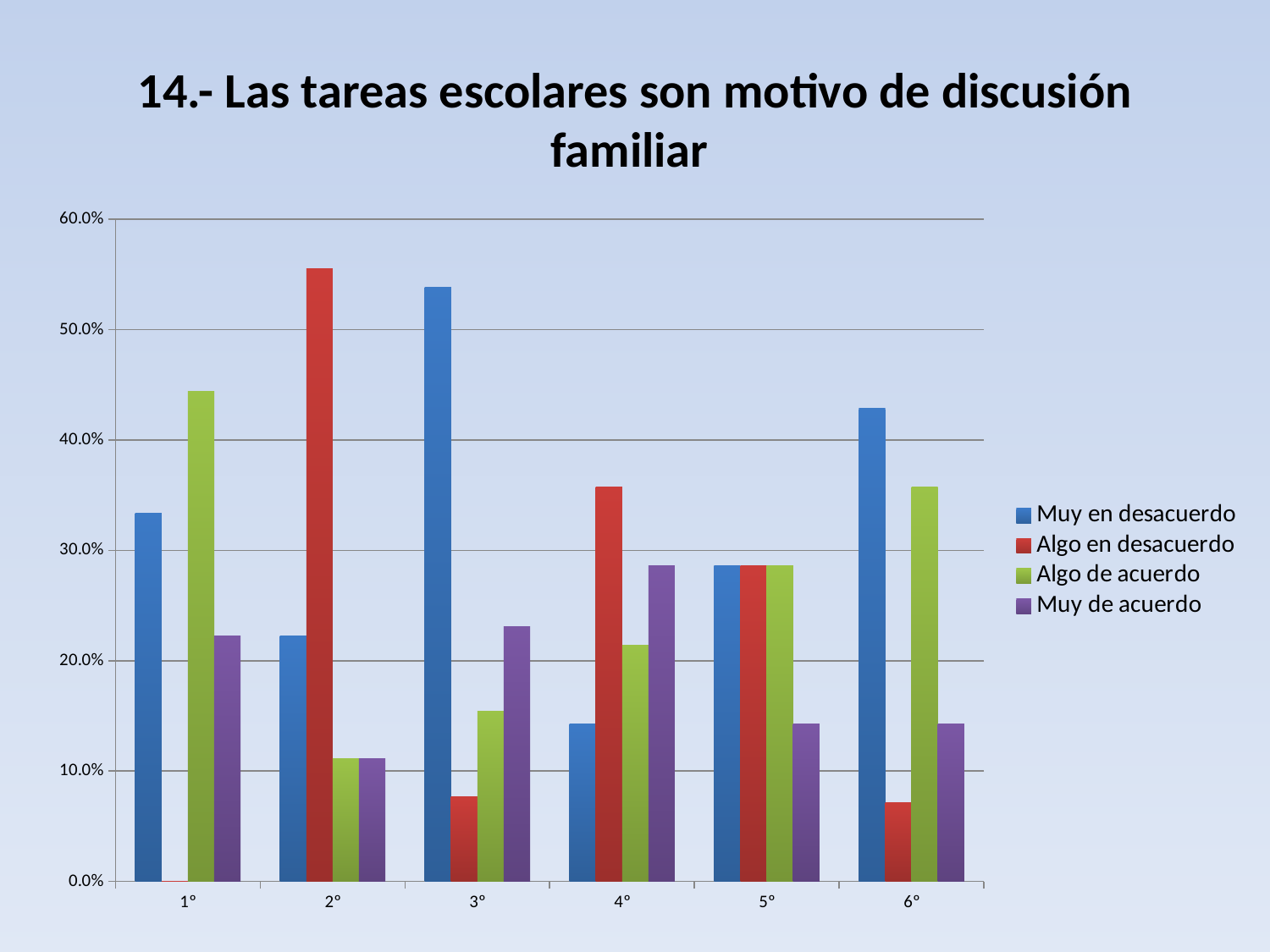
Is the value for 'Algo en desacuerdo' at 2° greater or less than 50.0%? greater Is the value for 'Algo en desacuerdo' at 3° greater or less than 10.0%? less What colour represents the 'Muy de acuerdo' series in the legend? Purple At 4°, which is larger: 'Algo en desacuerdo' or 'Muy en desacuerdo'? Algo en desacuerdo For which grade is the 'Algo en desacuerdo' bar the highest? 2° What kind of chart is shown on the slide? Bar chart How many grade categories are shown on the x axis? 6 For which grade is the 'Muy en desacuerdo' bar the lowest? 4° How many series does the legend list? 4 Is the value for 'Algo de acuerdo' at 1° greater or less than 40.0%? greater For which grade is the 'Muy en desacuerdo' bar the highest? 3° For which grade is the 'Algo de acuerdo' bar the highest? 1°